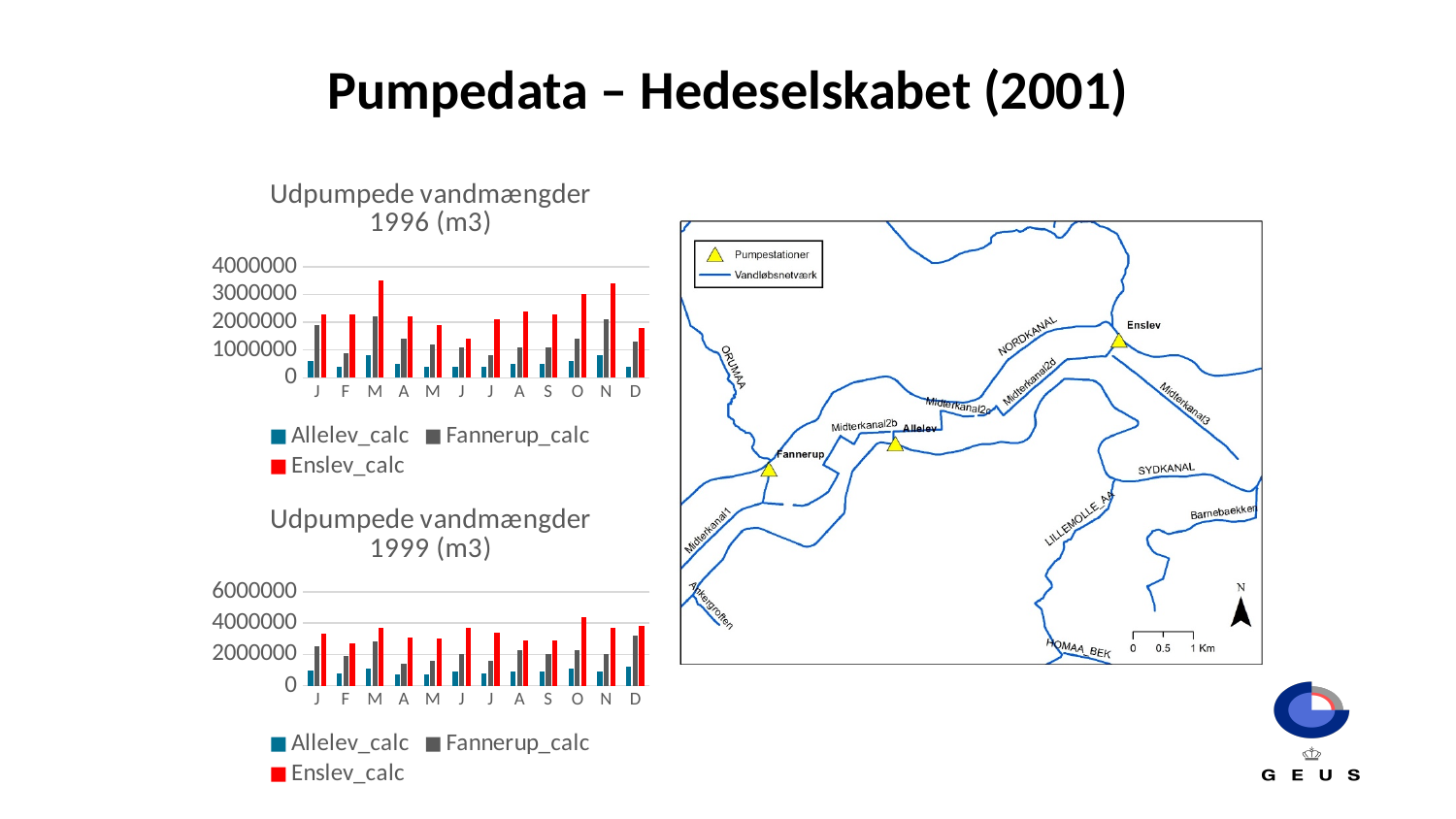
How many series does the legend of the 'Udpumpede vandmængder 1999 (m3)' chart list? 3 In the 'Udpumpede vandmængder 1996 (m3)' chart, in which month is the Enslev_calc value highest? M (March) In the 'Udpumpede vandmængder 1996 (m3)' chart, is the Allelev_calc value for January greater or less than 1000000? less In the 'Udpumpede vandmængder 1996 (m3)' chart, is the Enslev_calc value for March greater or less than 3000000? greater How many months are shown on the x axis of the 'Udpumpede vandmængder 1996 (m3)' chart? 12 In the 'Udpumpede vandmængder 1996 (m3)' chart, in which month is the Enslev_calc value lowest? J (June) What kind of chart is the 'Udpumpede vandmængder 1996 (m3)' chart? bar chart In the 'Udpumpede vandmængder 1999 (m3)' chart, is the Fannerup_calc value for March greater or less than 4000000? less What colour represents the Enslev_calc series in the charts? red In the 'Udpumpede vandmængder 1999 (m3)' chart, in which month is the Enslev_calc value highest? O (October) In the 'Udpumpede vandmængder 1999 (m3)' chart, which series has the larger value in January: Allelev_calc or Fannerup_calc? Fannerup_calc In the 'Udpumpede vandmængder 1996 (m3)' chart, which series has the larger value in March: Enslev_calc or Fannerup_calc? Enslev_calc